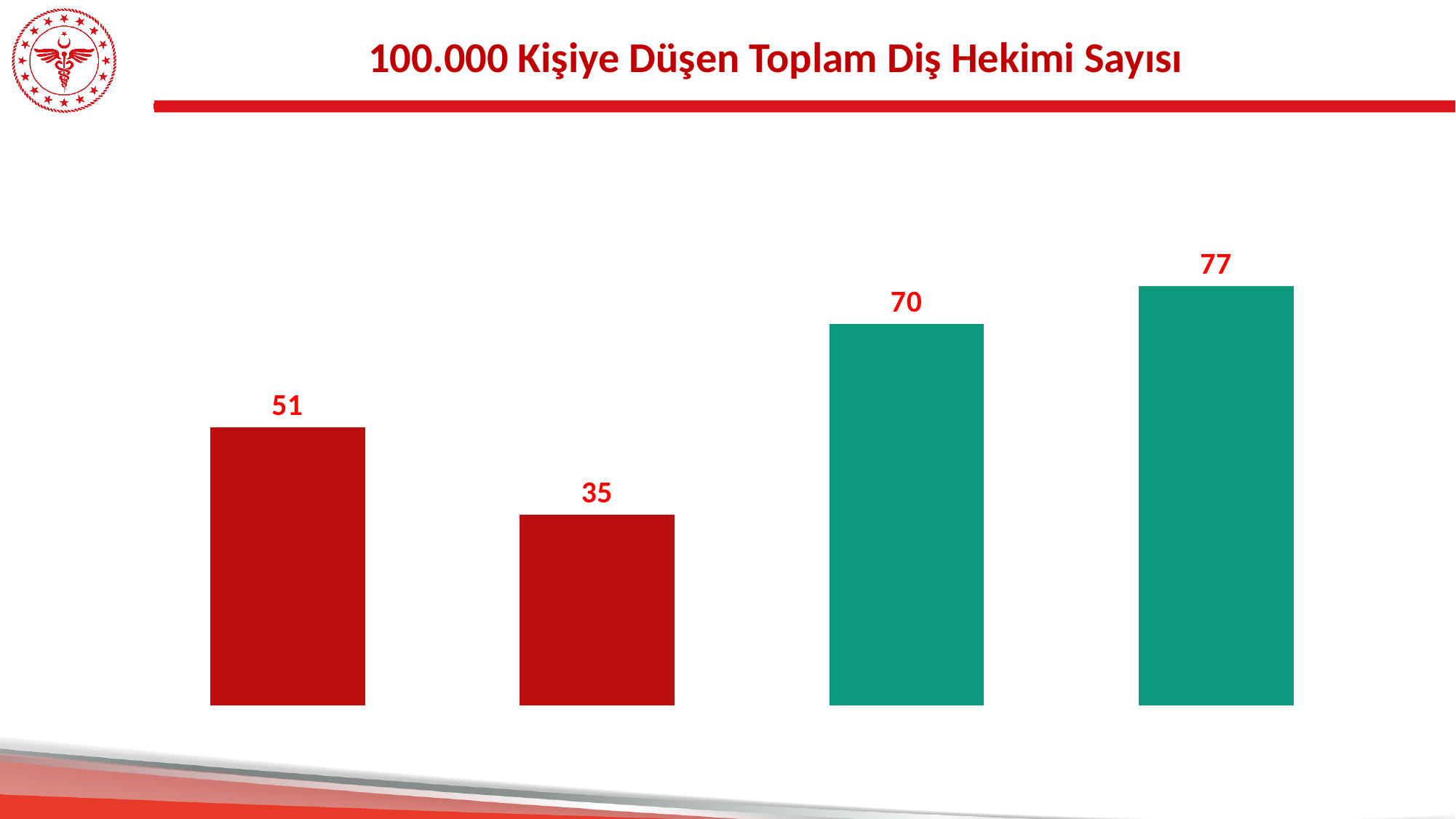
What is the difference between the rightmost bar's value and the leftmost bar's value? 26 What is the highest value shown in the chart? 77 Which is larger, the value of the first bar or the value of the second bar? the first bar (51) What is the lowest value shown in the chart? 35 How many bars are plotted in the chart? 4 What colour are the two rightmost bars? teal (green) What type of chart is shown on the slide? bar chart What is the value shown on the second bar from the left? 35 What is the title of the chart? 100.000 Kişiye Düşen Toplam Diş Hekimi Sayısı What is the value shown on the first (leftmost) bar? 51 What is the value shown on the fourth (rightmost) bar? 77 What is the value shown on the third bar from the left? 70